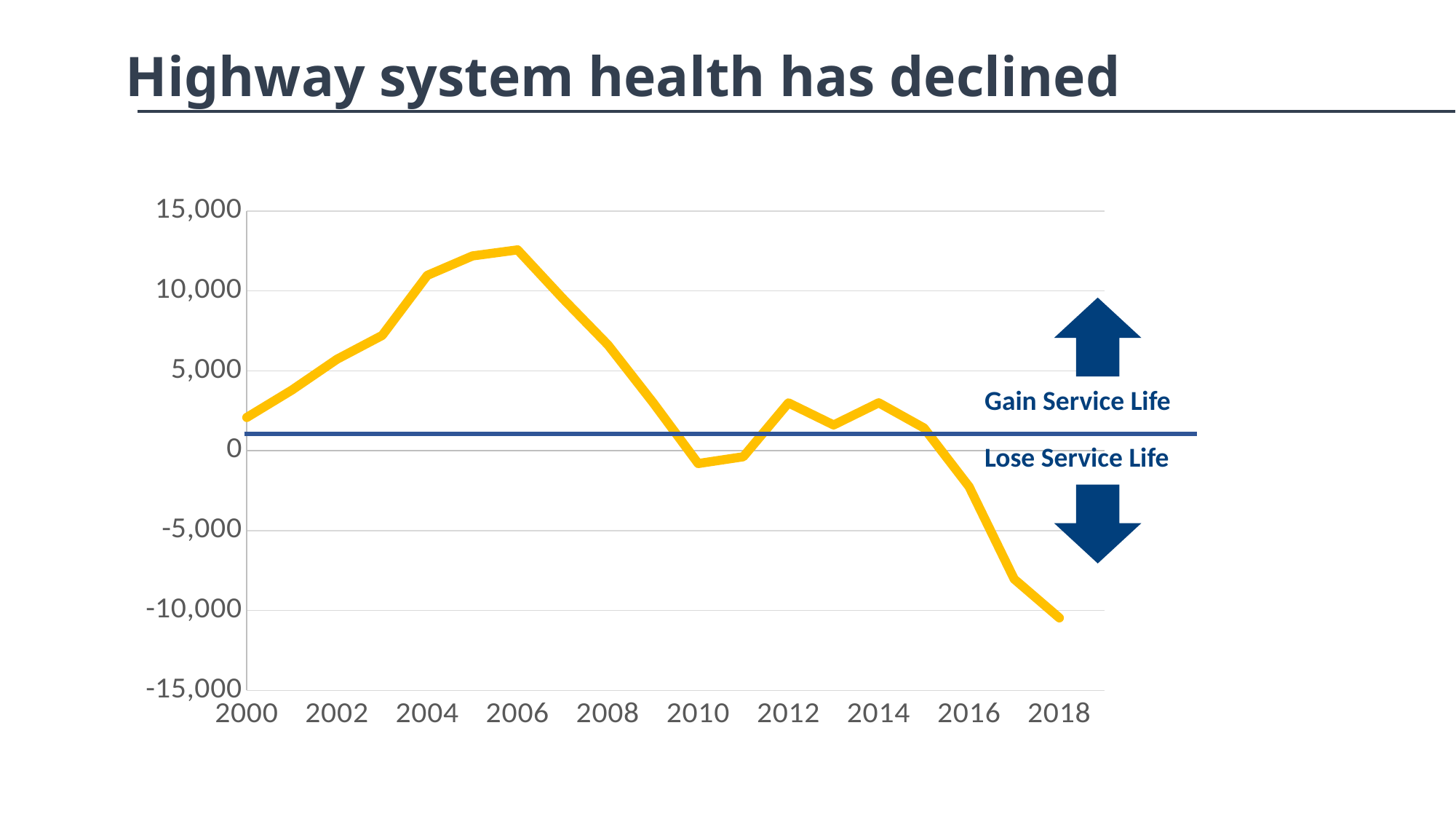
Is the value for 2006 greater or less than 10,000? greater In which year does the line reach its lowest value? 2018 In which year does the line reach its highest value? 2006 What is the title of the slide containing the chart? Highway system health has declined Is the value for 2018 greater or less than -10,000? less Which year has the larger value, 2004 or 2014? 2004 What kind of chart is shown on the slide? line chart Is the value for 2010 greater or less than 0? less What label appears above the horizontal blue line on the right side of the chart? Gain Service Life Does the line rise or fall between 2014 and 2018? fall Which year has the larger value, 2012 or 2016? 2012